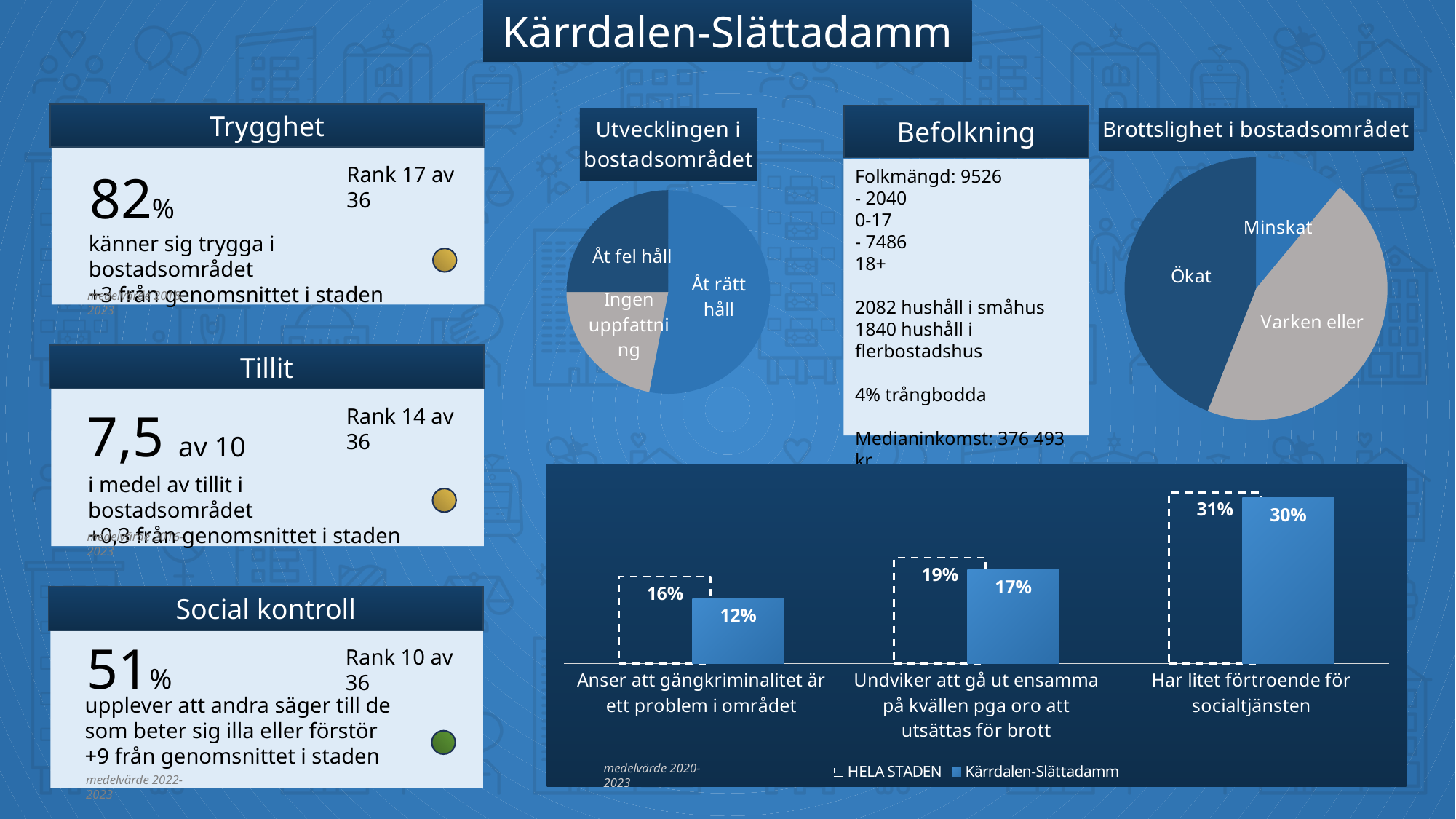
In the bar chart at the bottom of the slide, what is the difference between HELA STADEN and Kärrdalen-Slättadamm for 'Anser att gängkriminalitet är ett problem i området'? 4% How many series does the legend of the bar chart at the bottom of the slide list? 2 How many categories are shown in the bar chart at the bottom of the slide? 3 In the pie chart 'Brottslighet i bostadsområdet', which slice is the smallest? Minskat In the pie chart 'Utvecklingen i bostadsområdet', which slice is the largest? Åt rätt håll In the bar chart at the bottom of the slide, what is the value for Kärrdalen-Slättadamm for 'Undviker att gå ut ensamma på kvällen pga oro att utsättas för brott'? 17% In the bar chart at the bottom of the slide, which is larger for 'Undviker att gå ut ensamma på kvällen pga oro att utsättas för brott': HELA STADEN or Kärrdalen-Slättadamm? HELA STADEN In the bar chart at the bottom of the slide, what is the value for Kärrdalen-Slättadamm for 'Anser att gängkriminalitet är ett problem i området'? 12% In the bar chart at the bottom of the slide, which category has the lowest value for HELA STADEN? Anser att gängkriminalitet är ett problem i området What kind of chart is 'Utvecklingen i bostadsområdet'? Pie chart In the bar chart at the bottom of the slide, what is the value for HELA STADEN for 'Har litet förtroende för socialtjänsten'? 31% In the bar chart at the bottom of the slide, which category has the highest value for Kärrdalen-Slättadamm? Har litet förtroende för socialtjänsten